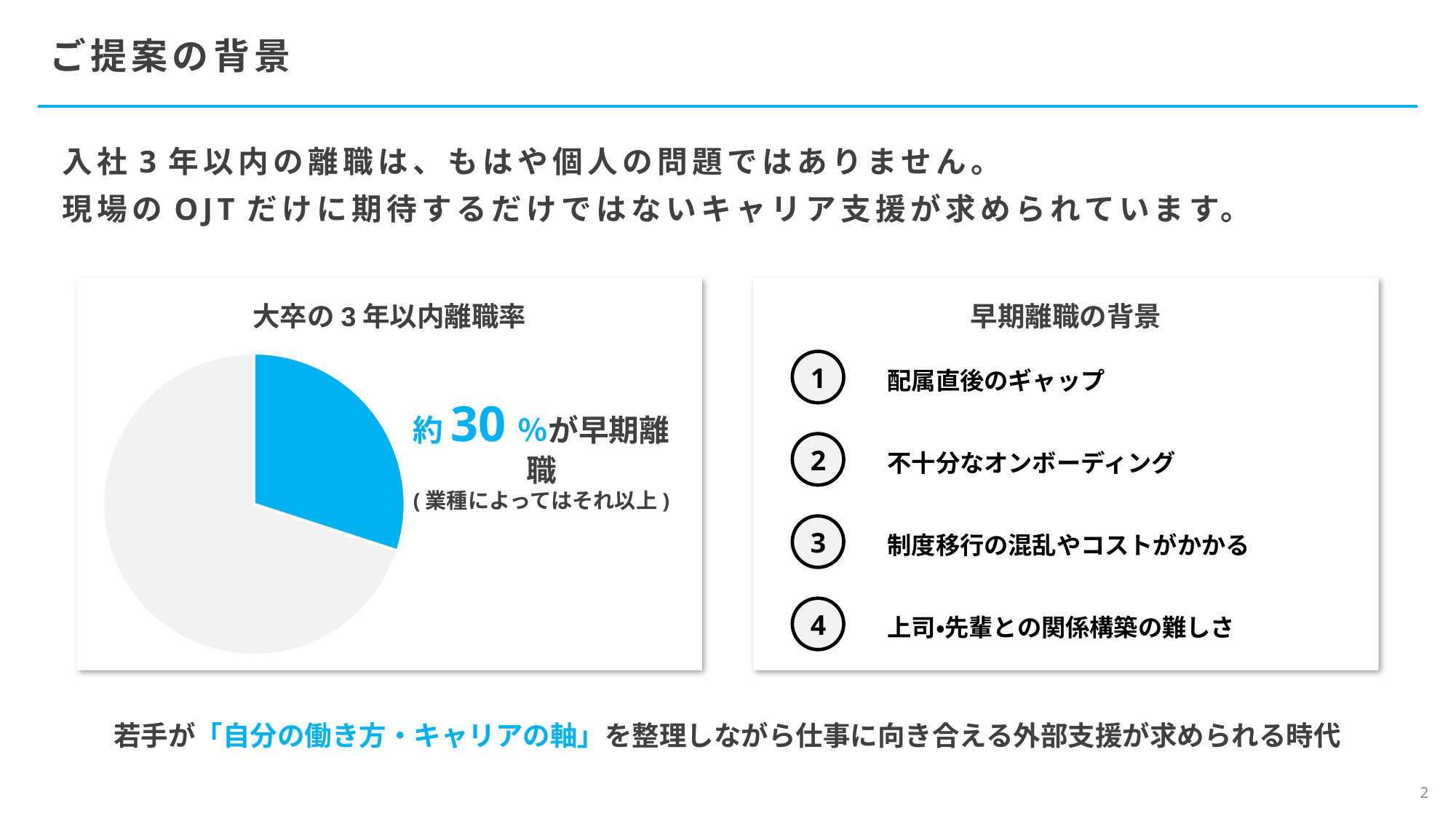
What is the title of the pie chart on the left? 大卒の3年以内離職率 What note in parentheses accompanies the 約30% label on the pie chart? 業種によってはそれ以上 Is the blue slice of the pie chart more or less than half of the pie? Less What kind of chart is shown on the left side of the slide? Pie chart How many slices does the pie chart have? 2 What colour is the slice representing early leavers (早期離職) in the pie chart? Blue According to the label next to the pie chart, what share of graduates leave within 3 years? 約30% Which slice of the pie chart is larger, the blue slice or the grey slice? The grey slice